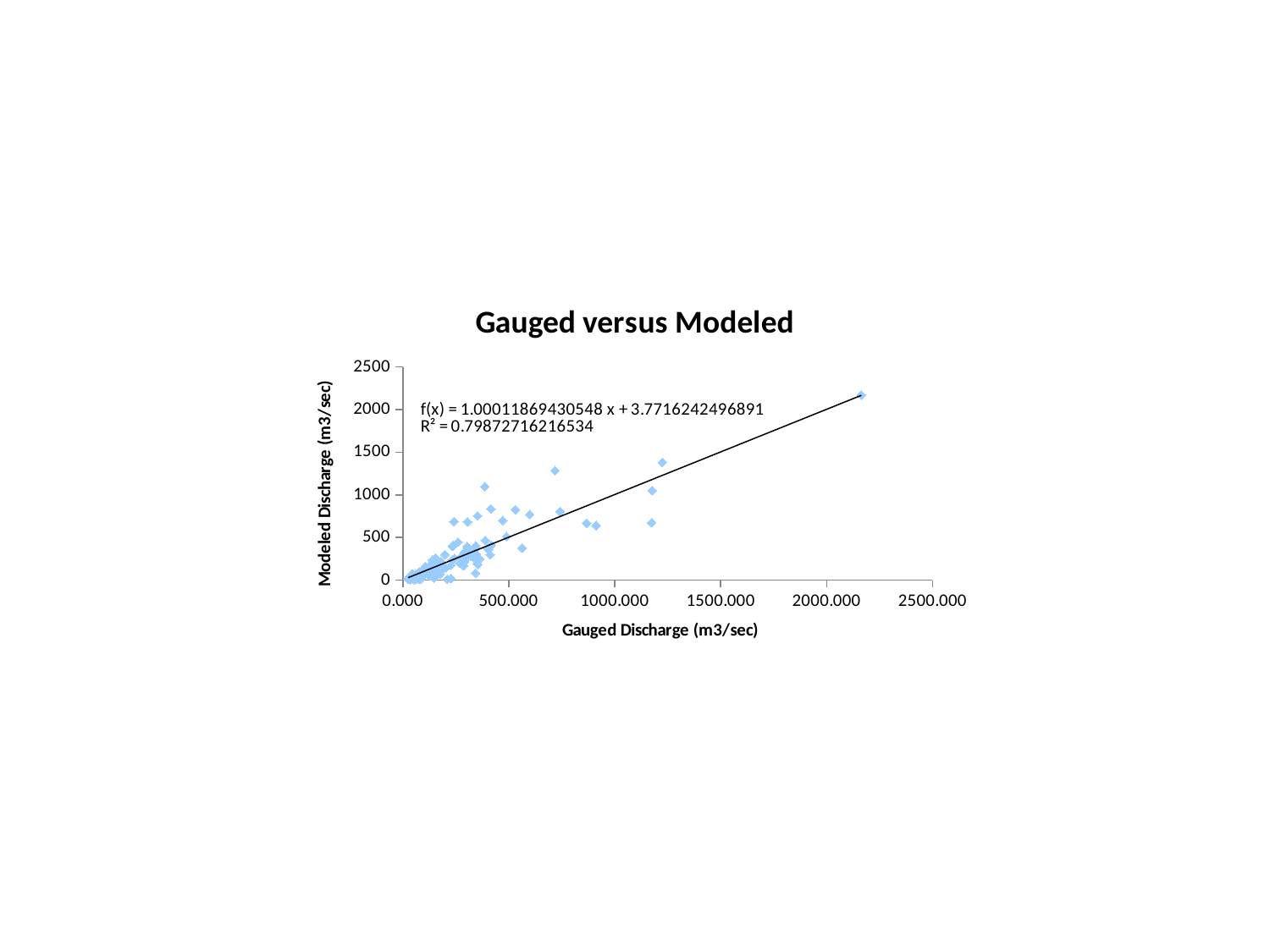
What is the title of the chart? Gauged versus Modeled What is the trendline equation printed on the chart? f(x) = 1.00011869430548 x + 3.7716242496891 What is the intercept of the fitted trendline shown on the chart? 3.7716242496891 Is the gauged discharge of the point farthest to the right greater or less than 2000.000? greater What is the slope of the fitted trendline shown on the chart? 1.00011869430548 Does the trendline rise or fall as gauged discharge increases? Rises What is the maximum value shown on the horizontal axis? 2500.000 What is the maximum value shown on the vertical axis? 2500 Is the modeled discharge of the highest point on the chart greater or less than 2000? greater What is the label of the horizontal axis of the chart? Gauged Discharge (m3/sec) What kind of chart is shown on the slide? Scatter plot What R² value is printed on the chart? 0.79872716216534